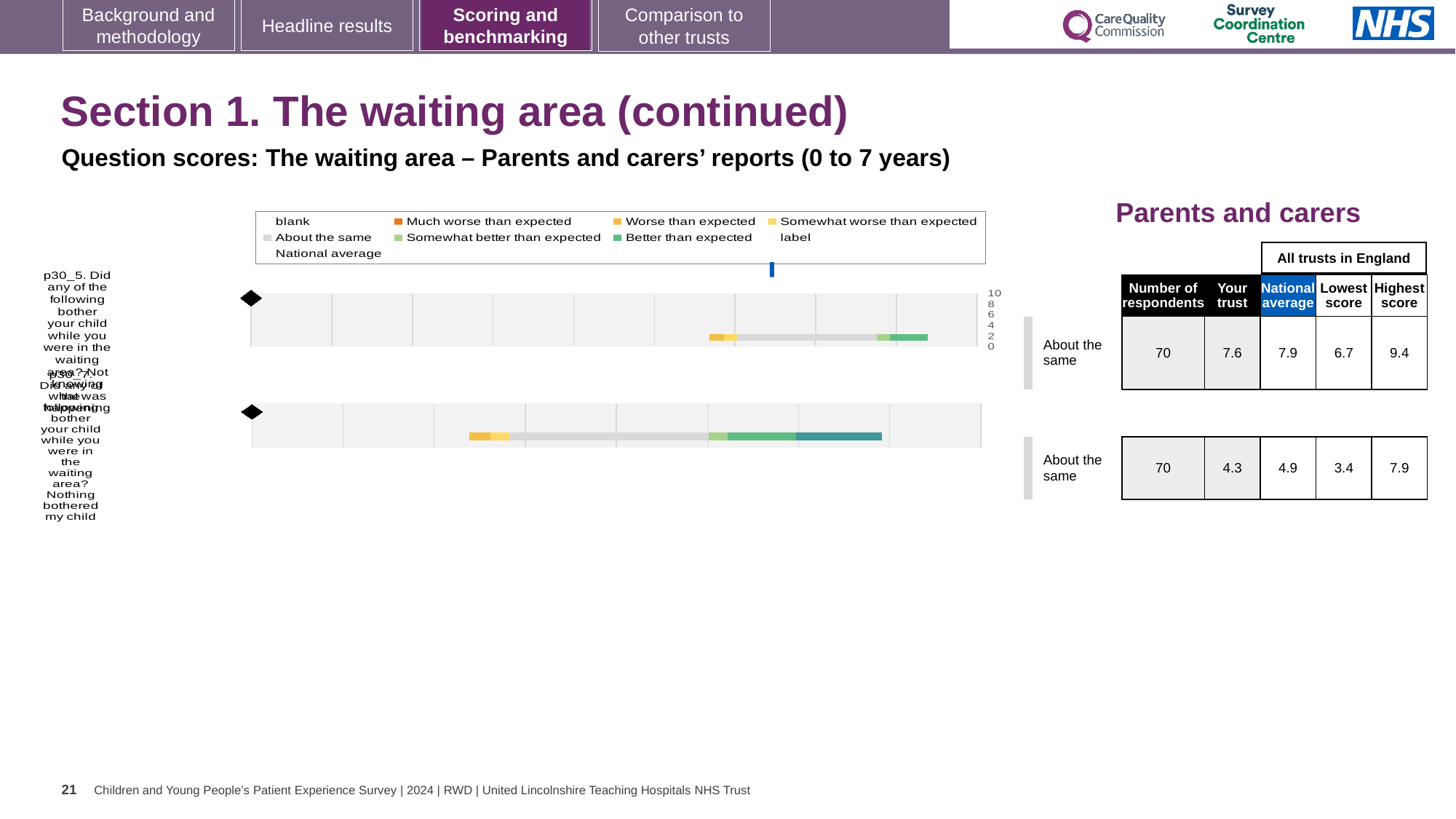
How many question bars are plotted in the chart? 2 How many entries does the chart legend list? 9 For question p30_7, which is larger: the 'Your trust' score or the national average? National average What kind of chart is shown on the slide? bar chart What is the national average score for question p30_7? 4.9 Which question has the higher 'Your trust' score, p30_5 or p30_7? p30_5 How many respondents are recorded for question p30_5? 70 What is the difference between the highest score and the lowest score for question p30_5? 2.7 What is the 'Your trust' score for question p30_5? 7.6 What is the highest score among all trusts in England for question p30_7? 7.9 What benchmark category is shown for question p30_7? About the same What heading appears above the table to the right of the chart? Parents and carers